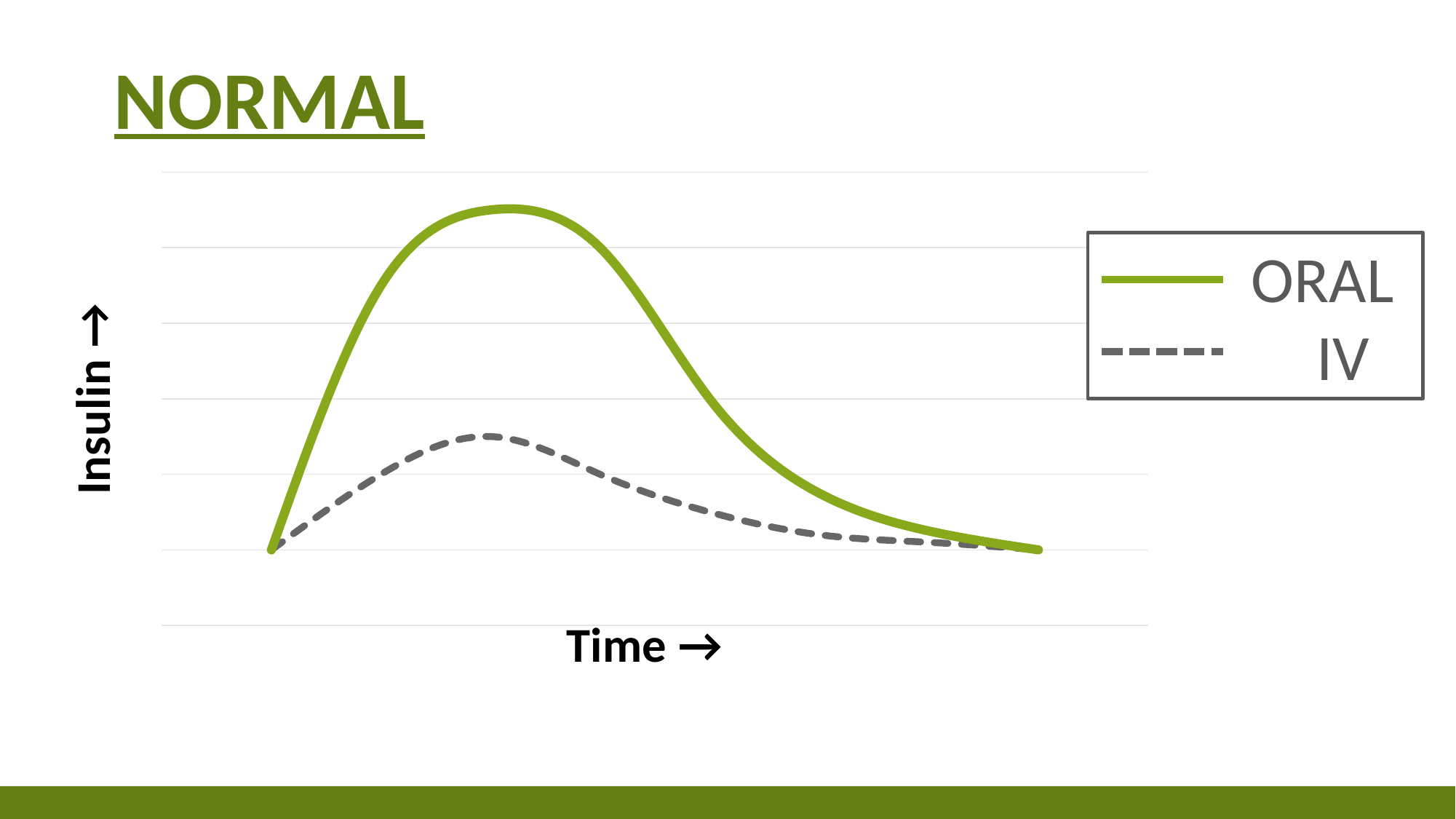
How many series does the legend list? 2 Which series has the highest insulin level on the chart? ORAL How does the IV series change along the time axis? rises to a peak, then falls What kind of chart is shown on the slide? line chart How does the ORAL series change along the time axis? rises to a peak, then falls Which series reaches the higher peak, ORAL or IV? ORAL What is the label of the vertical axis? Insulin Which series has the lower peak insulin level? IV Which series is drawn with a dashed line? IV